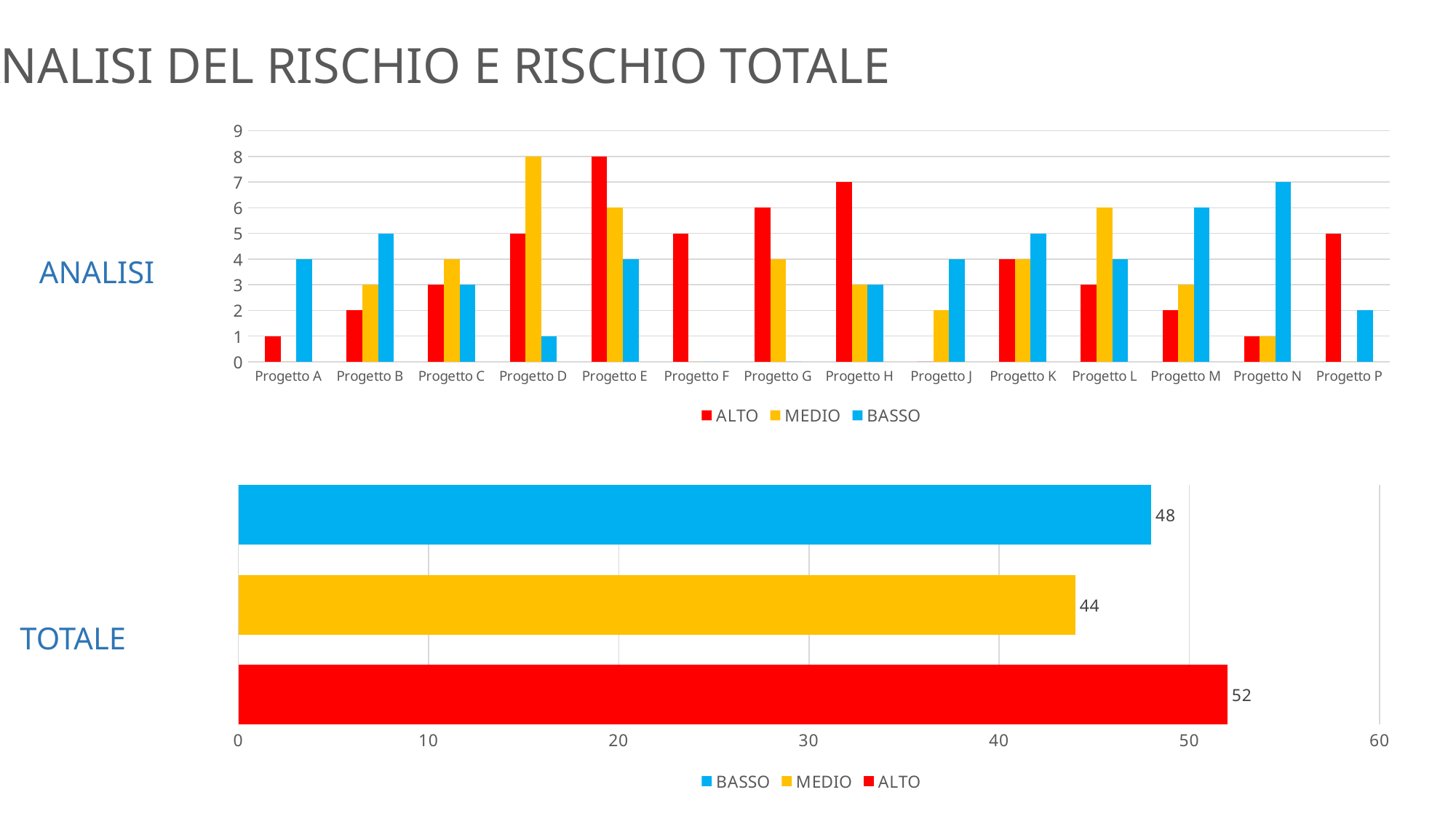
In the ANALISI chart, what is the BASSO value for Progetto N? 7 How many projects are shown on the x axis of the ANALISI chart? 14 In the TOTALE chart, what is the value for MEDIO? 44 In the TOTALE chart, what is the difference between the BASSO and MEDIO values? 4 In the TOTALE chart, what is the value for ALTO? 52 In the ANALISI chart, what is the ALTO value for Progetto E? 8 In the TOTALE chart, which category has the lowest value? MEDIO In the TOTALE chart, which category has the highest value? ALTO In the TOTALE chart, is the value for BASSO greater or less than 50? less What kind of chart is the TOTALE chart? bar chart In the ANALISI chart, what is the MEDIO value for Progetto D? 8 How many series does the legend of the ANALISI chart list? 3